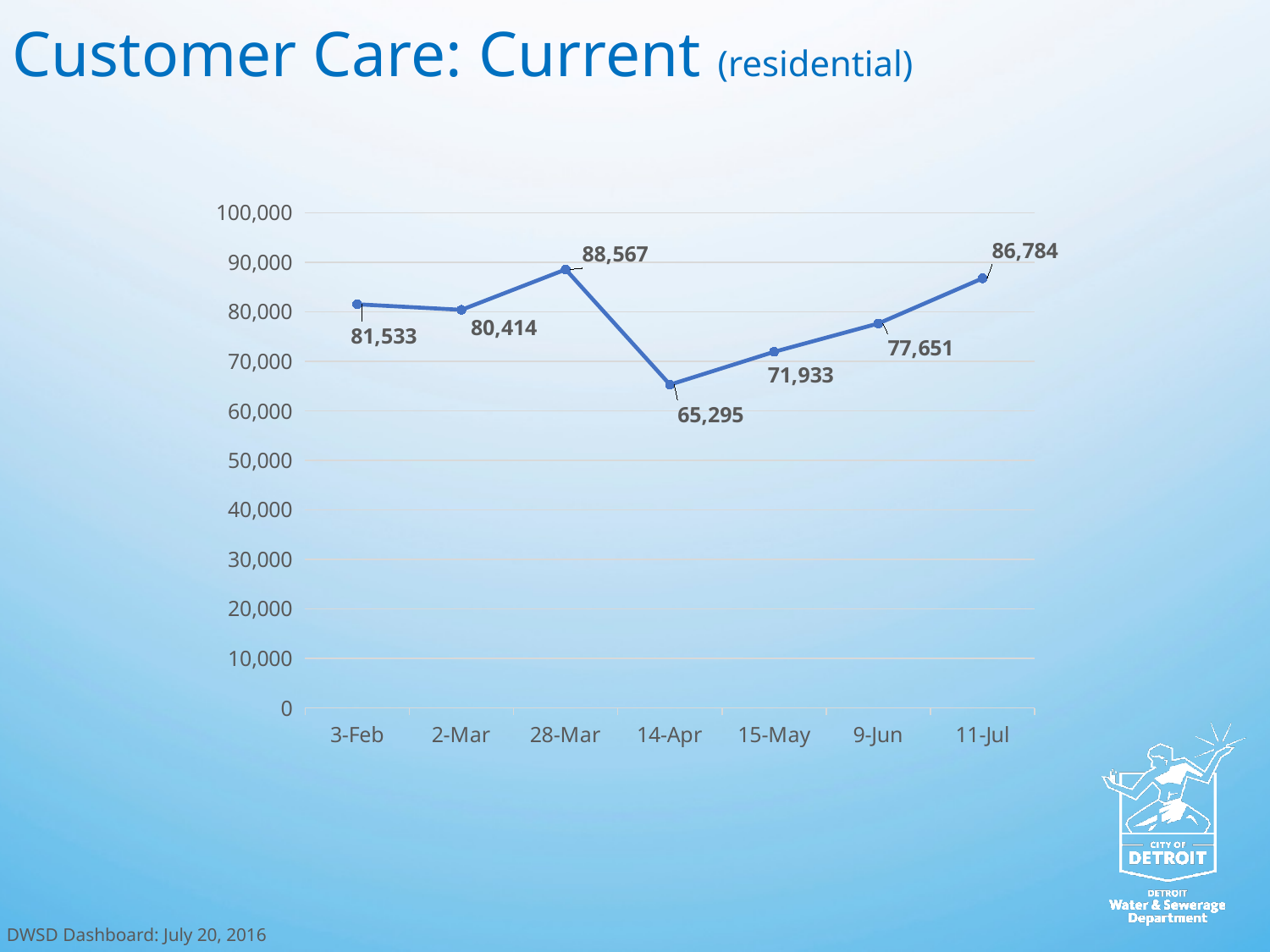
Which date has the lowest value? 14-Apr Which date has the highest value? 28-Mar What kind of chart is shown on the slide? line chart What is the value for 14-Apr? 65,295 Which is larger, the value for 15-May or the value for 9-Jun? 9-Jun What is the difference between the values for 28-Mar and 14-Apr? 23,272 Do the values rise or fall from 14-Apr to 11-Jul? rise How many data points are plotted on the chart? 7 What is the value for 3-Feb? 81,533 Is the value for 2-Mar greater or less than 70,000? greater What is the value for 11-Jul? 86,784 What is the difference between the values for 11-Jul and 9-Jun? 9,133